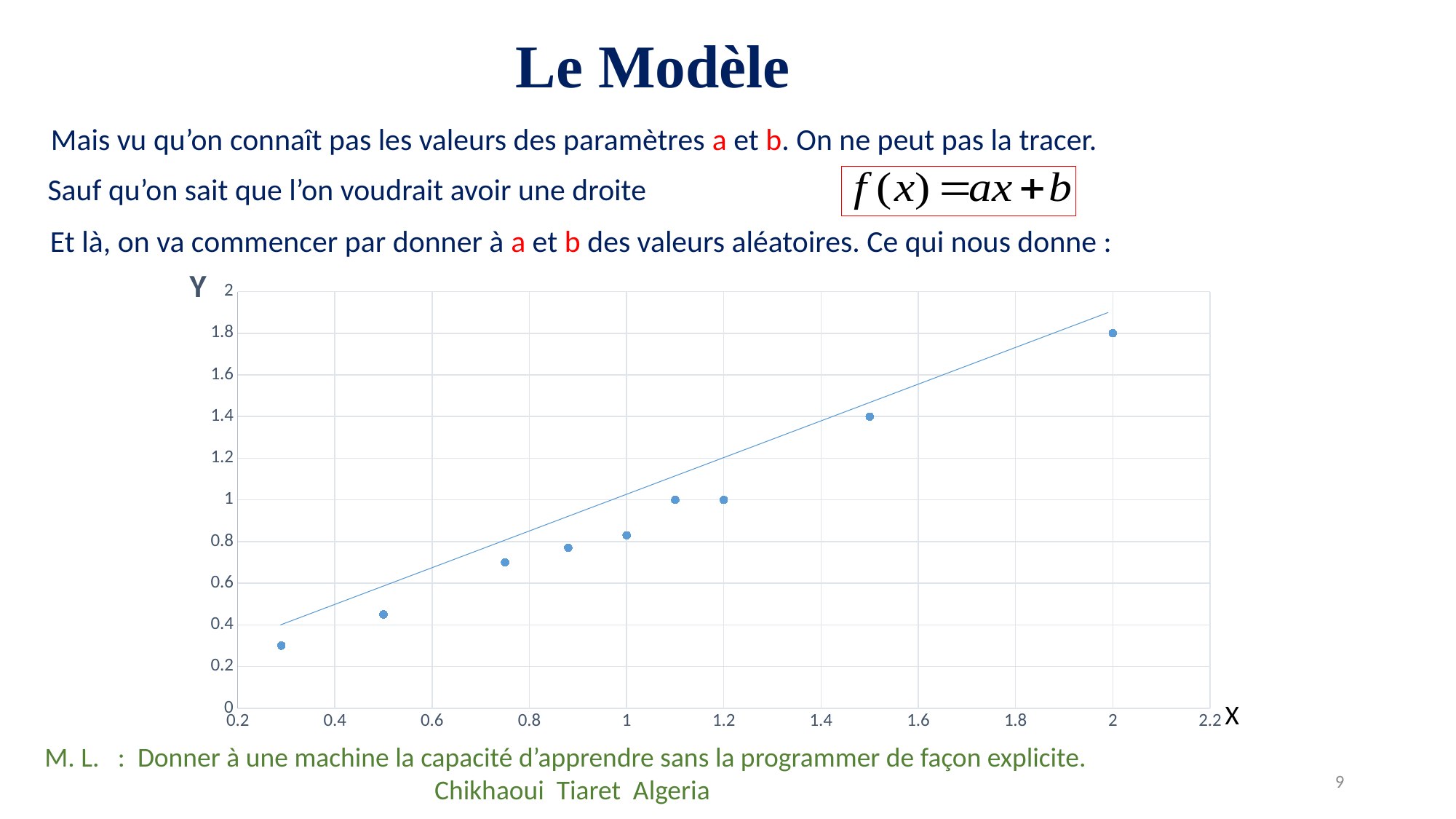
Is the Y value of the leftmost point greater or less than 0.4? less What is the label of the vertical axis? Y Is the Y value of the point at X = 1.5 greater or less than 1.2? greater Is the Y value of the point at X = 0.5 greater or less than 0.6? less What is the highest value shown on the X axis? 2.2 Do the plotted Y values generally rise or fall as X increases? rise How many data points are plotted on the chart? 9 What kind of chart is shown on the slide? scatter chart Which point has the highest Y value: the one at X = 2 or the one at X = 1.5? the one at X = 2 Which point has the lowest Y value on the chart? the leftmost point, near X = 0.3